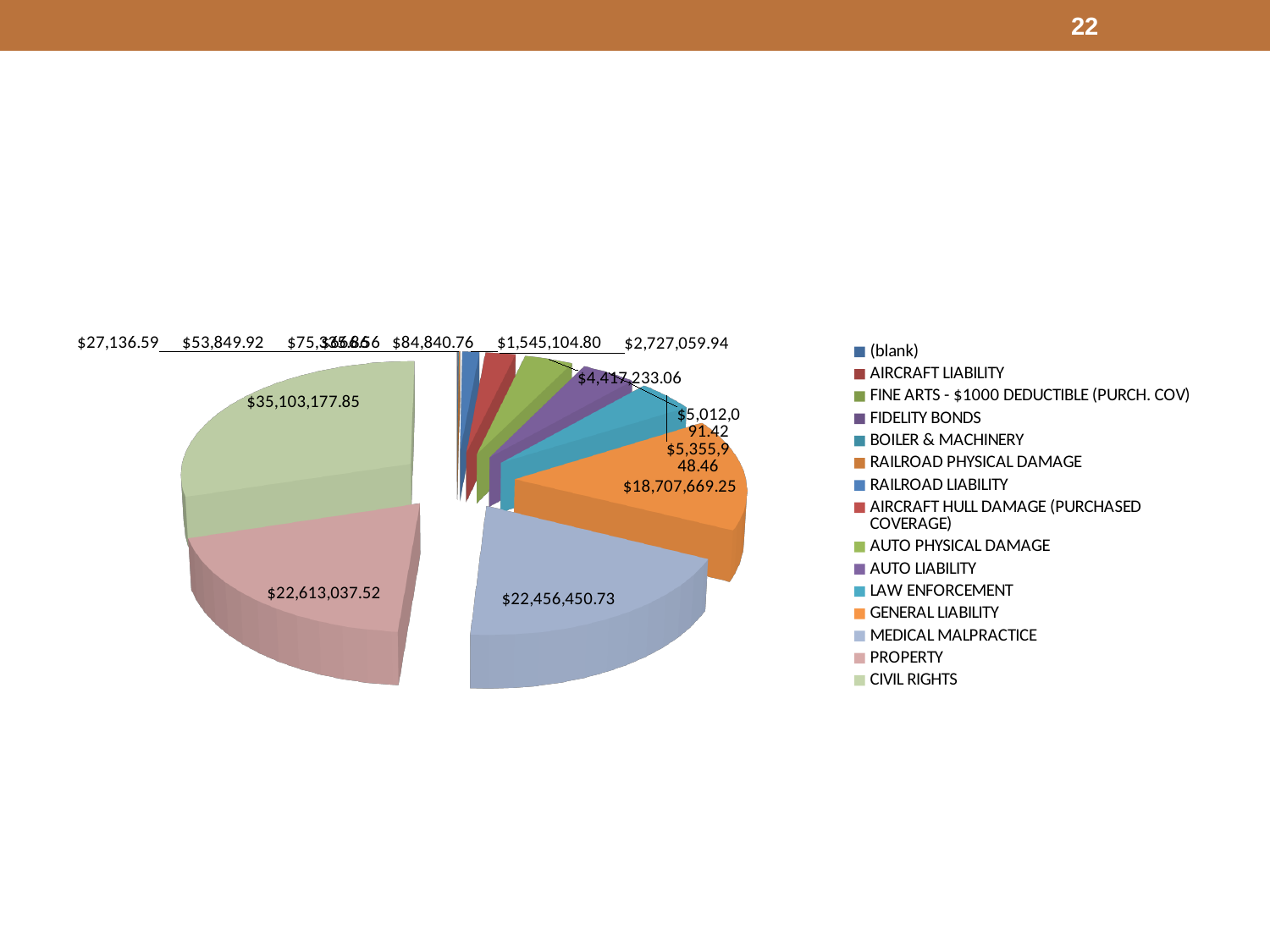
What is the first entry listed in the pie chart's legend? (blank) How many categories does the legend of the pie chart list? 15 What is the value shown for the AUTO PHYSICAL DAMAGE slice? $4,417,233.06 What is the difference between the CIVIL RIGHTS value and the PROPERTY value? $12,490,140.33 What kind of chart is shown on the slide? Pie chart What is the value shown for the CIVIL RIGHTS slice? $35,103,177.85 Which category has the largest slice of the pie chart? CIVIL RIGHTS Which is larger, the PROPERTY value or the MEDICAL MALPRACTICE value? PROPERTY What is the value shown for the GENERAL LIABILITY slice? $18,707,669.25 What is the value shown for the PROPERTY slice? $22,613,037.52 What is the value shown for the MEDICAL MALPRACTICE slice? $22,456,450.73 What is the difference between the PROPERTY value and the MEDICAL MALPRACTICE value? $156,586.79